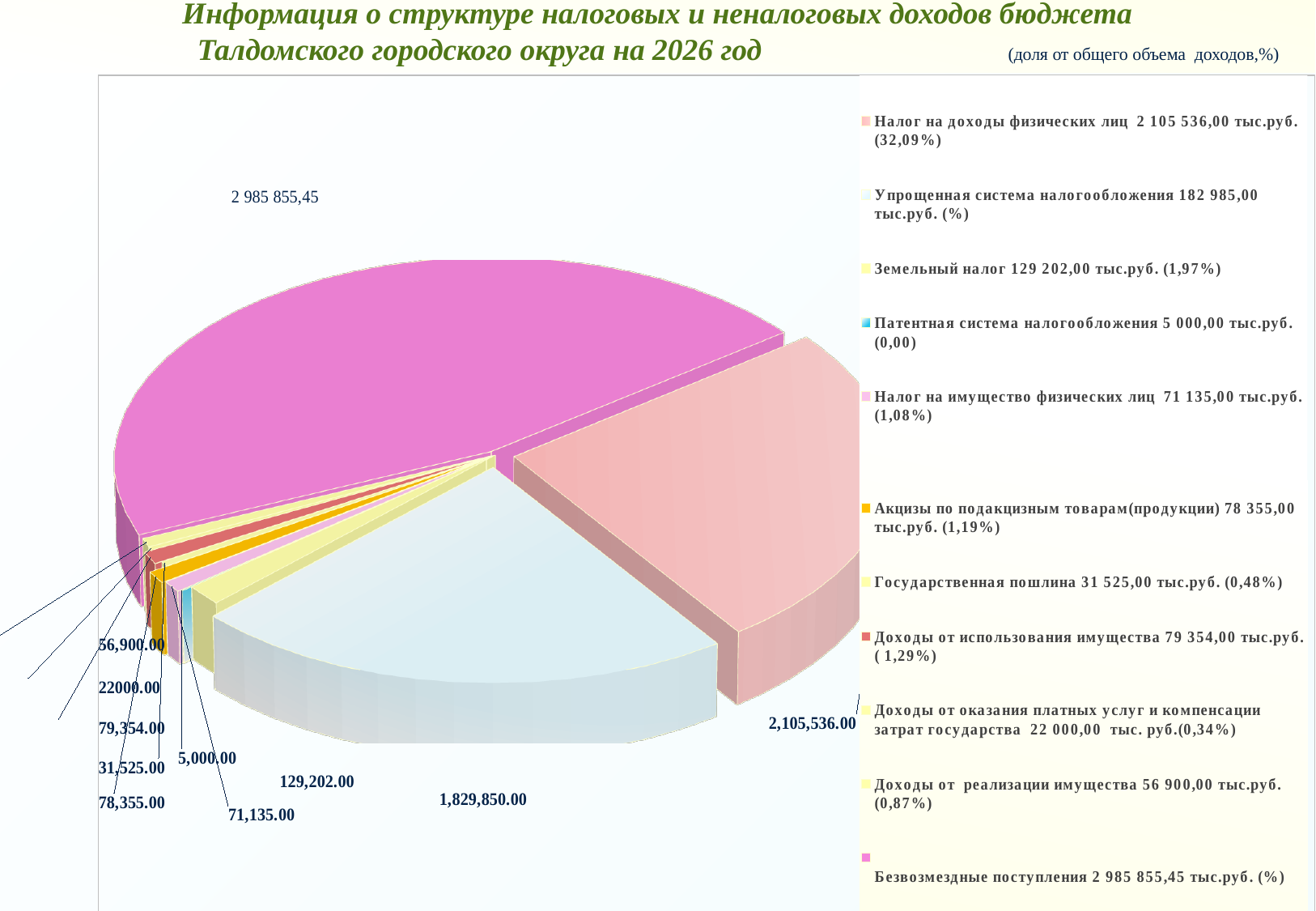
What colour is the slice for Безвозмездные поступления? pink (magenta) Which category has the smallest slice of the pie? Патентная система налогообложения What kind of chart is shown on the slide? pie chart What is the value shown for Государственная пошлина? 31,525.00 How many categories (slices) does the pie chart have? 11 What is the value shown for Земельный налог? 129,202.00 What share of total revenue does Акцизы по подакцизным товарам(продукции) represent, according to the legend? 1,19% What is the difference between Доходы от реализации имущества (56,900.00) and Доходы от оказания платных услуг и компенсации затрат государства (22000.00)? 34,900.00 Which category has the largest slice of the pie? Безвозмездные поступления Which is larger: Доходы от использования имущества or Акцизы по подакцизным товарам(продукции)? Доходы от использования имущества What is the value shown for Налог на доходы физических лиц? 2,105,536.00 What share of total revenue does Налог на доходы физических лиц represent, according to the legend? 32,09%